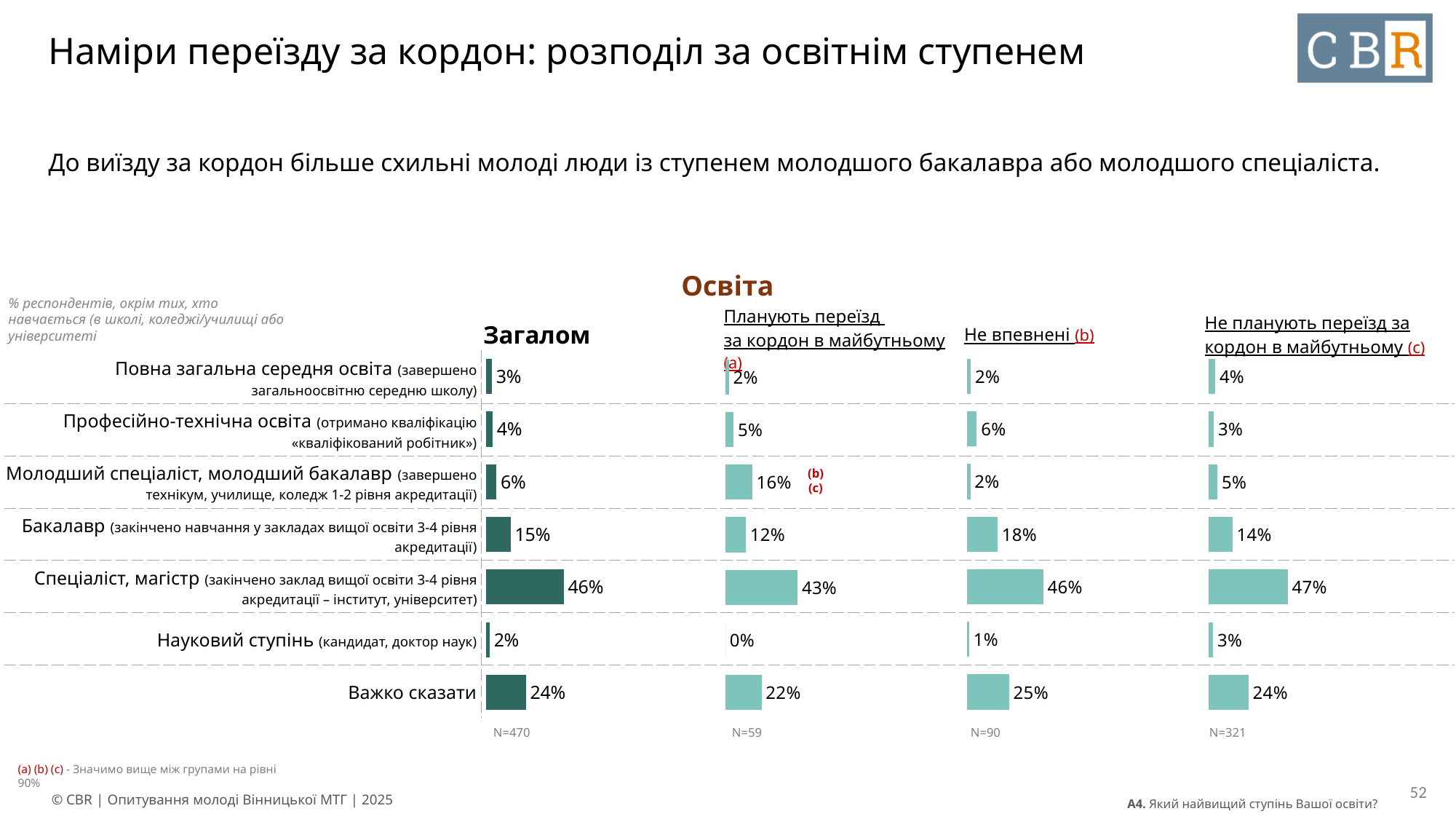
In the "Не планують переїзд за кордон в майбутньому" chart, what is the value for "Важко сказати"? 24% In the "Загалом" chart, which category has the highest value? Спеціаліст, магістр In the "Не впевнені" chart, what is the value for "Бакалавр"? 18% In the "Планують переїзд за кордон в майбутньому" chart, what is the value for "Молодший спеціаліст, молодший бакалавр"? 16% In the "Не впевнені" chart, what is the difference between "Спеціаліст, магістр" and "Важко сказати"? 21% How many categories does the "Загалом" chart show? 7 In the "Планують переїзд за кордон в майбутньому" chart, which category has the lowest value? Науковий ступінь In the "Не планують переїзд за кордон в майбутньому" chart, what is the difference between "Бакалавр" and "Професійно-технічна освіта"? 11% What type of chart is used for the "Загалом" column? Bar chart In the "Планують переїзд за кордон в майбутньому" chart, which is larger: "Молодший спеціаліст, молодший бакалавр" or "Бакалавр"? Молодший спеціаліст, молодший бакалавр What is the sample size (N) shown under the "Планують переїзд за кордон в майбутньому" chart? N=59 In the "Загалом" chart, what is the value for "Спеціаліст, магістр"? 46%